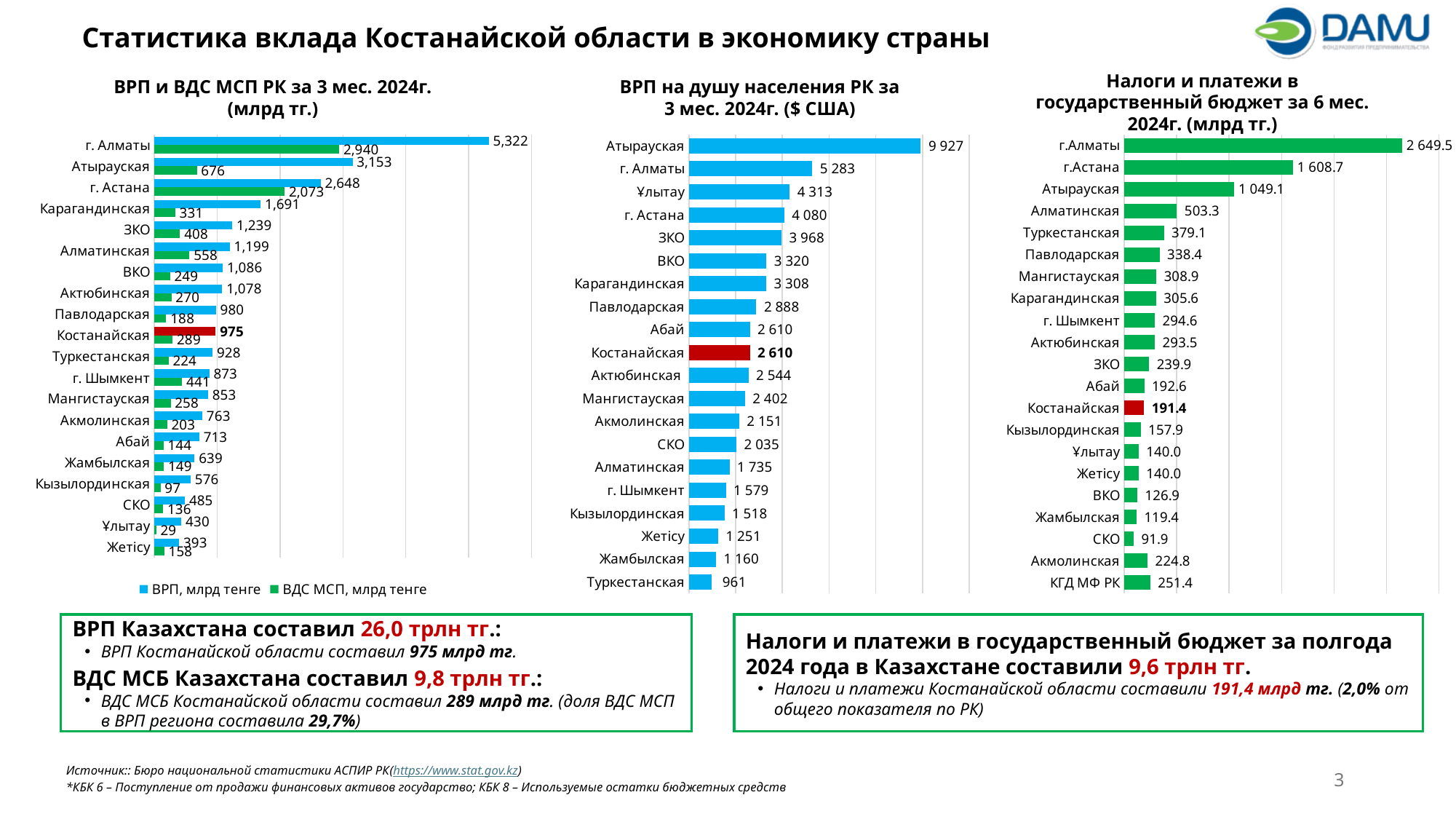
In the chart 'ВРП и ВДС МСП РК за 3 мес. 2024г.', what is the ВДС МСП value for Атырауская? 676 In the chart 'ВРП на душу населения РК за 3 мес. 2024г.', what is the value for г. Астана? 4 080 How many categories are shown in the chart 'Налоги и платежи в государственный бюджет за 6 мес. 2024г.'? 21 In the chart 'Налоги и платежи в государственный бюджет за 6 мес. 2024г.', what is the difference between г.Алматы and г.Астана? 1 040.8 In the chart 'ВРП на душу населения РК за 3 мес. 2024г.', which region has the highest value? Атырауская In the chart 'Налоги и платежи в государственный бюджет за 6 мес. 2024г.', what is the value for Костанайская? 191.4 In the chart 'ВРП и ВДС МСП РК за 3 мес. 2024г.', what is the difference between the ВРП and ВДС МСП values for г. Алматы? 2,382 In the chart 'ВРП на душу населения РК за 3 мес. 2024г.', which region has the lowest value? Туркестанская How many series does the legend of the chart 'ВРП и ВДС МСП РК за 3 мес. 2024г.' list? 2 In the chart 'ВРП и ВДС МСП РК за 3 мес. 2024г.', what is the ВРП value for Костанайская? 975 In the chart 'ВРП на душу населения РК за 3 мес. 2024г.', which is larger: ЗКО or ВКО? ЗКО What kind of chart is 'ВРП на душу населения РК за 3 мес. 2024г.'? bar chart